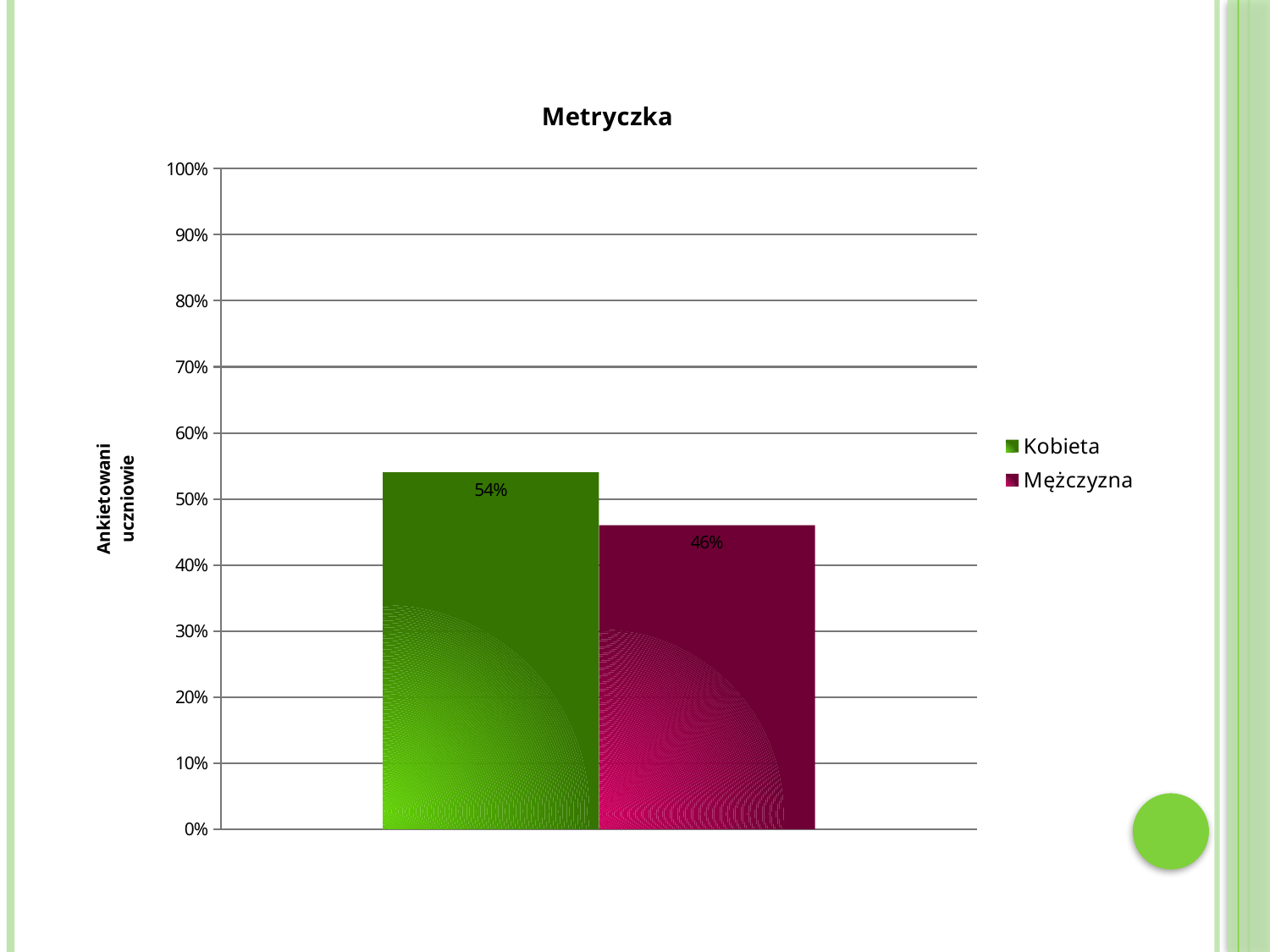
Is the value for Mężczyzna greater or less than 50%? less How many series does the legend list? 2 What is the difference between the values for Kobieta and Mężczyzna? 8% Which is larger, the value for Kobieta or the value for Mężczyzna? Kobieta What kind of chart is shown? bar chart What is the value for Mężczyzna? 46% Which series has the highest value? Kobieta What is the title of the chart? Metryczka Is the value for Kobieta greater or less than 50%? greater What is the label on the vertical axis? Ankietowani uczniowie What is the value for Kobieta? 54% Which series has the lowest value? Mężczyzna